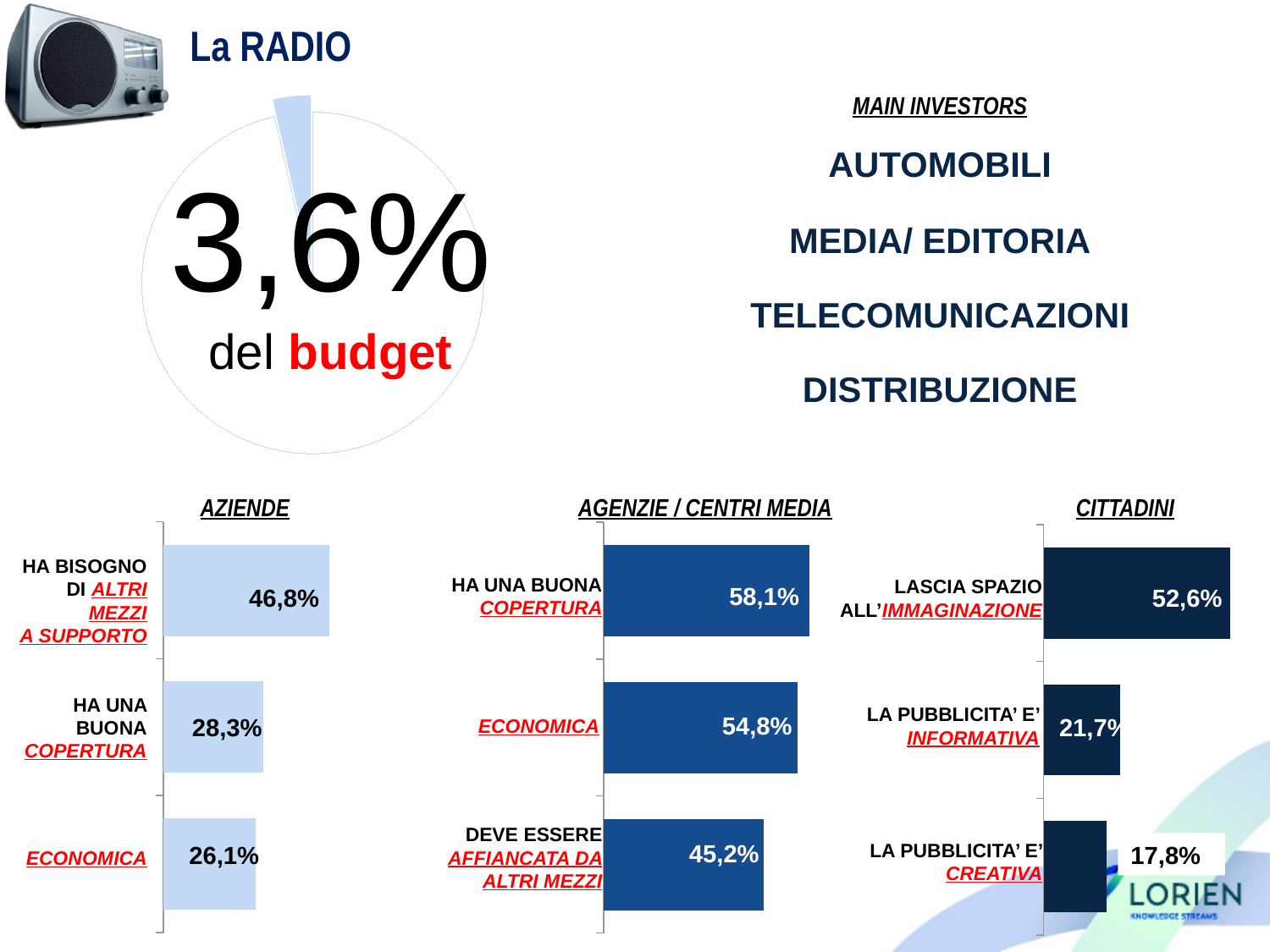
What kind of chart is the AZIENDE chart? Bar chart How many categories does the AGENZIE / CENTRI MEDIA chart show? 3 What share of the budget does the pie chart show for radio? 3,6% In the AGENZIE / CENTRI MEDIA chart, what is the difference between 'HA UNA BUONA COPERTURA' and 'DEVE ESSERE AFFIANCATA DA ALTRI MEZZI'? 12,9% In the AGENZIE / CENTRI MEDIA chart, which category has the highest value? HA UNA BUONA COPERTURA In the AZIENDE chart, what is the value for 'HA BISOGNO DI ALTRI MEZZI A SUPPORTO'? 46,8% In the AZIENDE chart, which category has the lowest value? ECONOMICA What kind of chart is the one showing '3,6% del budget'? Pie chart In the CITTADINI chart, what is the value for 'LA PUBBLICITA' E' INFORMATIVA'? 21,7% In the AGENZIE / CENTRI MEDIA chart, what is the value for 'ECONOMICA'? 54,8% In the CITTADINI chart, what is the difference between 'LASCIA SPAZIO ALL'IMMAGINAZIONE' and 'LA PUBBLICITA' E' CREATIVA'? 34,8% In the AZIENDE chart, which is larger: 'HA UNA BUONA COPERTURA' or 'ECONOMICA'? HA UNA BUONA COPERTURA